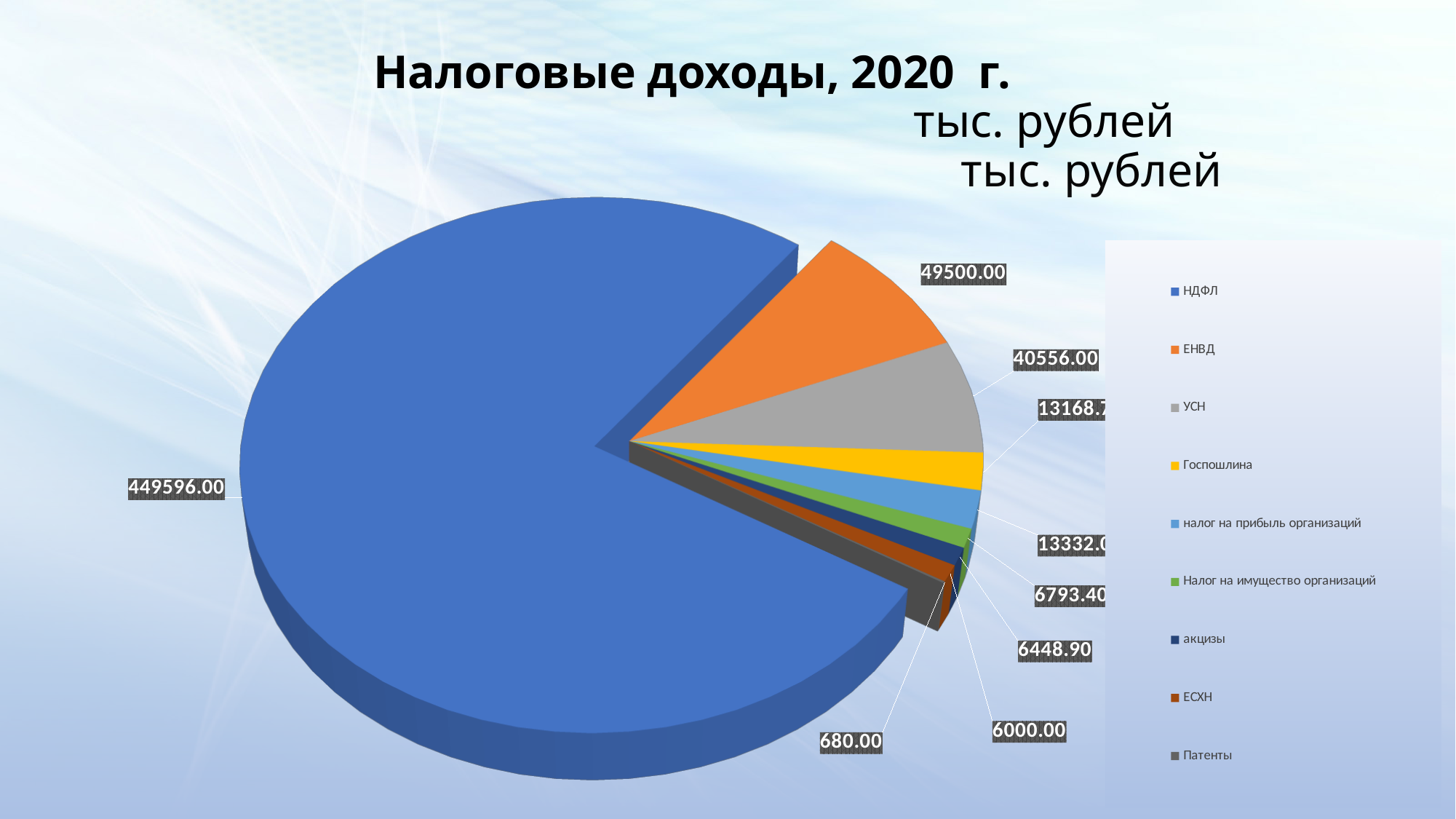
What is the value for акцизы? 6448.90 What is the smallest value labelled on the chart? 680.00 What is the value for НДФЛ? 449596.00 What is the value for УСН? 40556.00 What is the value for ЕНВД? 49500.00 Which is larger, ЕНВД or УСН? ЕНВД What is the difference between the values for ЕНВД and УСН? 8944.00 Which category has the largest slice of the pie? НДФЛ What type of chart is shown on the slide? pie chart What is the title of the chart? Налоговые доходы, 2020 г. What is the value for Налог на имущество организаций? 6793.40 How many categories does the legend list? 9